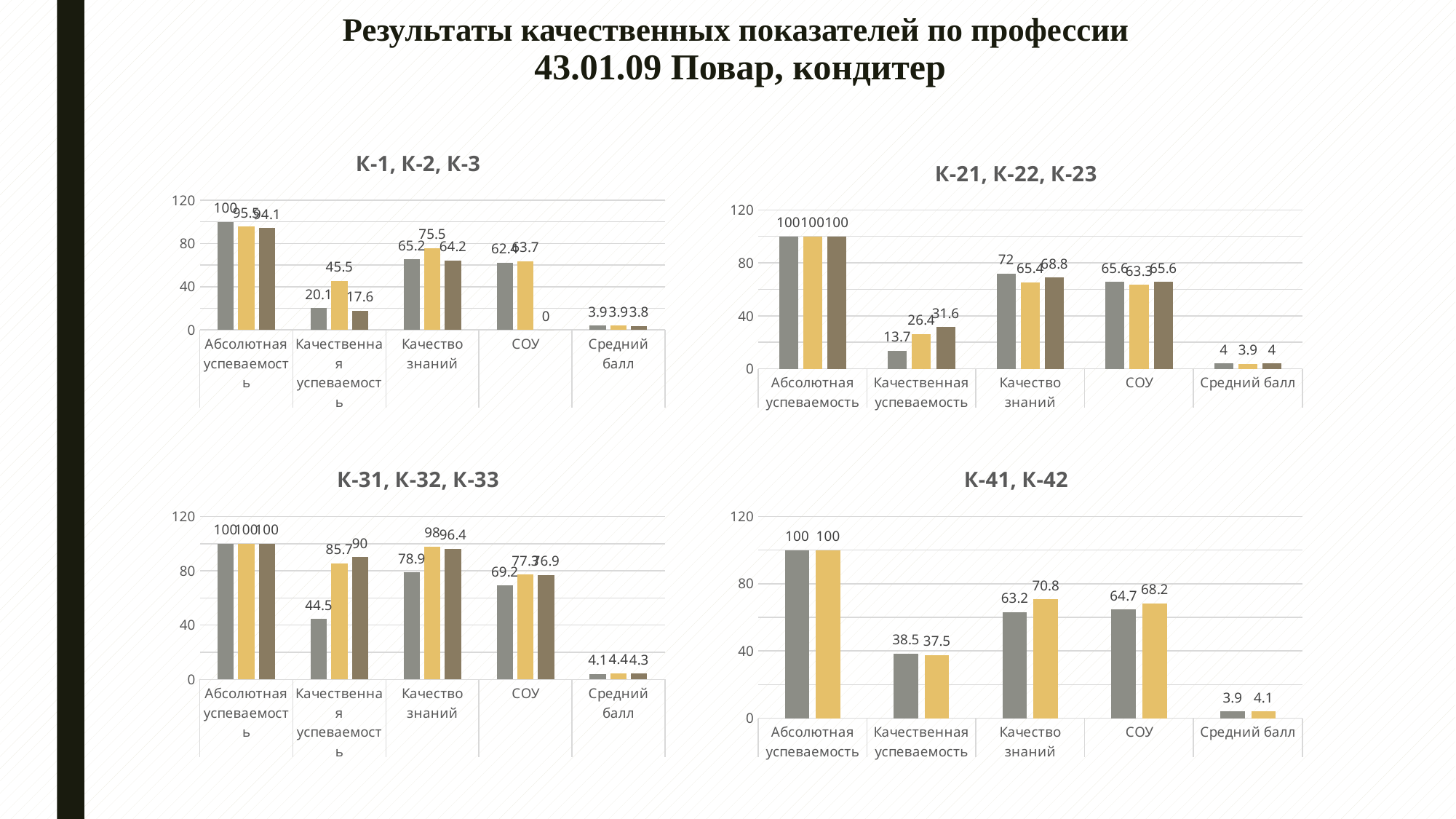
In the "К-21, К-22, К-23" chart, which of the three bars for "Качественная успеваемость" is the highest? the third (brown) bar, 31.6 In the "К-31, К-32, К-33" chart, what is the value of the third (brown) bar for "Качественная успеваемость"? 90 In the "К-31, К-32, К-33" chart, what is the difference between the second (yellow) and first (grey) bars for "Качество знаний"? 19.1 What kind of chart is the "К-41, К-42" chart? bar chart In the "К-21, К-22, К-23" chart, what is the value of the first (grey) bar for "Качественная успеваемость"? 13.7 How many categories are shown on the x axis of the "К-41, К-42" chart? 5 In the "К-41, К-42" chart, what is the difference between the two bars for "Качество знаний"? 7.6 How many bars are shown for each category in the "К-41, К-42" chart? 2 In the "К-41, К-42" chart, which bar for "Качественная успеваемость" is larger, the first (grey) or the second (yellow)? the first (grey), 38.5 In the "К-31, К-32, К-33" chart, is the first (grey) bar for "Качественная успеваемость" greater or less than 40? greater In the "К-41, К-42" chart, what is the value of the second (yellow) bar for "Качество знаний"? 70.8 In the "К-1, К-2, К-3" chart, what is the value of the second (yellow) bar for "Качественная успеваемость"? 45.5